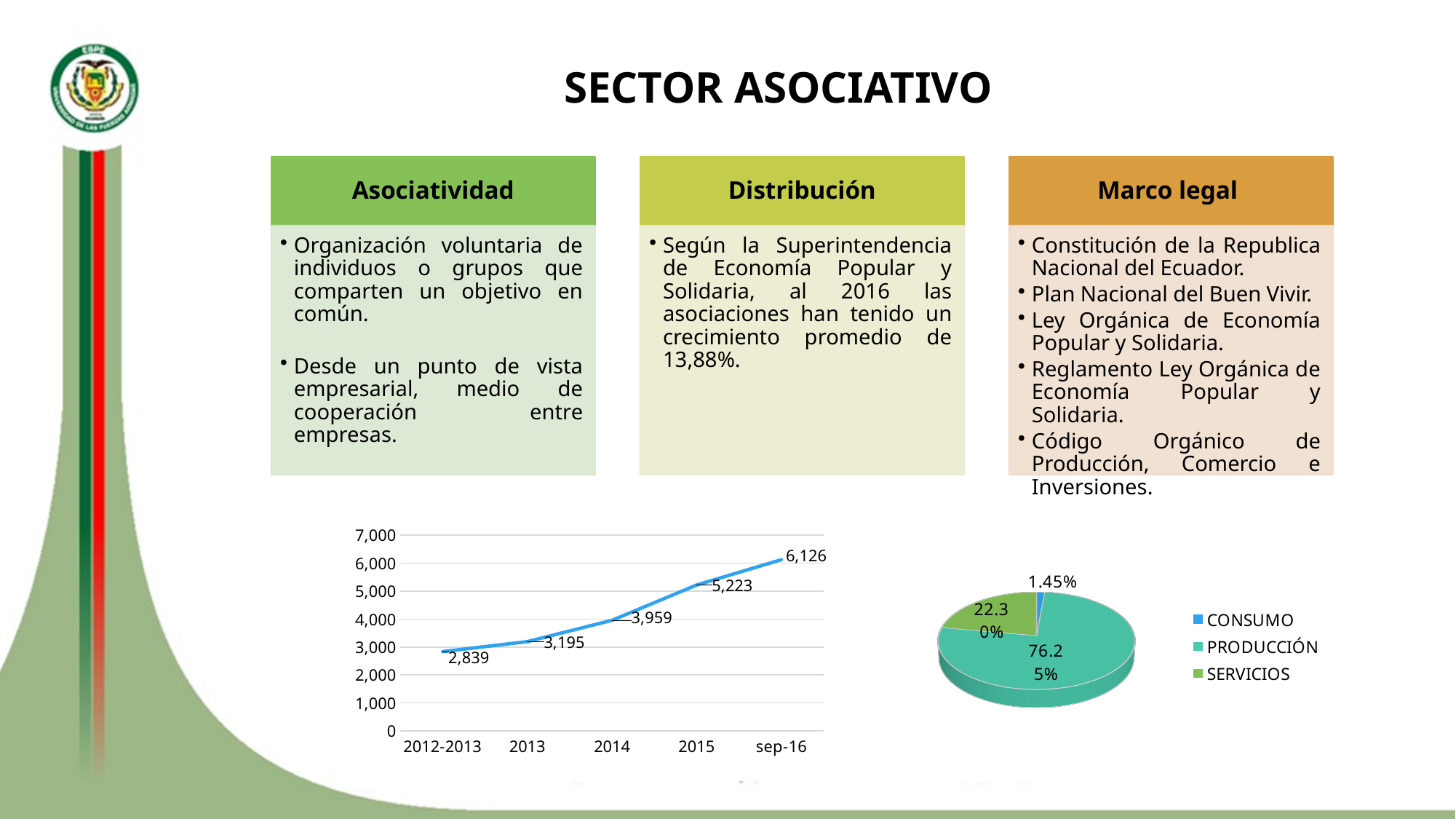
In the line chart on the left, do the values rise or fall from 2012-2013 to sep-16? rise In the line chart on the left, which is larger, the value for 2013 or the value for 2015? 2015 In the line chart on the left, what is the difference between the values for 2015 and 2014? 1,264 In the line chart on the left, what is the value for 2014? 3,959 In the line chart on the left, how many data points are plotted? 5 In the line chart on the left, what is the value for sep-16? 6,126 In the line chart on the left, which category has the lowest value? 2012-2013 In the pie chart on the right, which category has the largest slice? PRODUCCIÓN In the line chart on the left, which category has the highest value? sep-16 What kind of chart is the chart on the left? line chart In the line chart on the left, what is the value for 2012-2013? 2,839 In the pie chart on the right, what is the share for CONSUMO? 1.45%